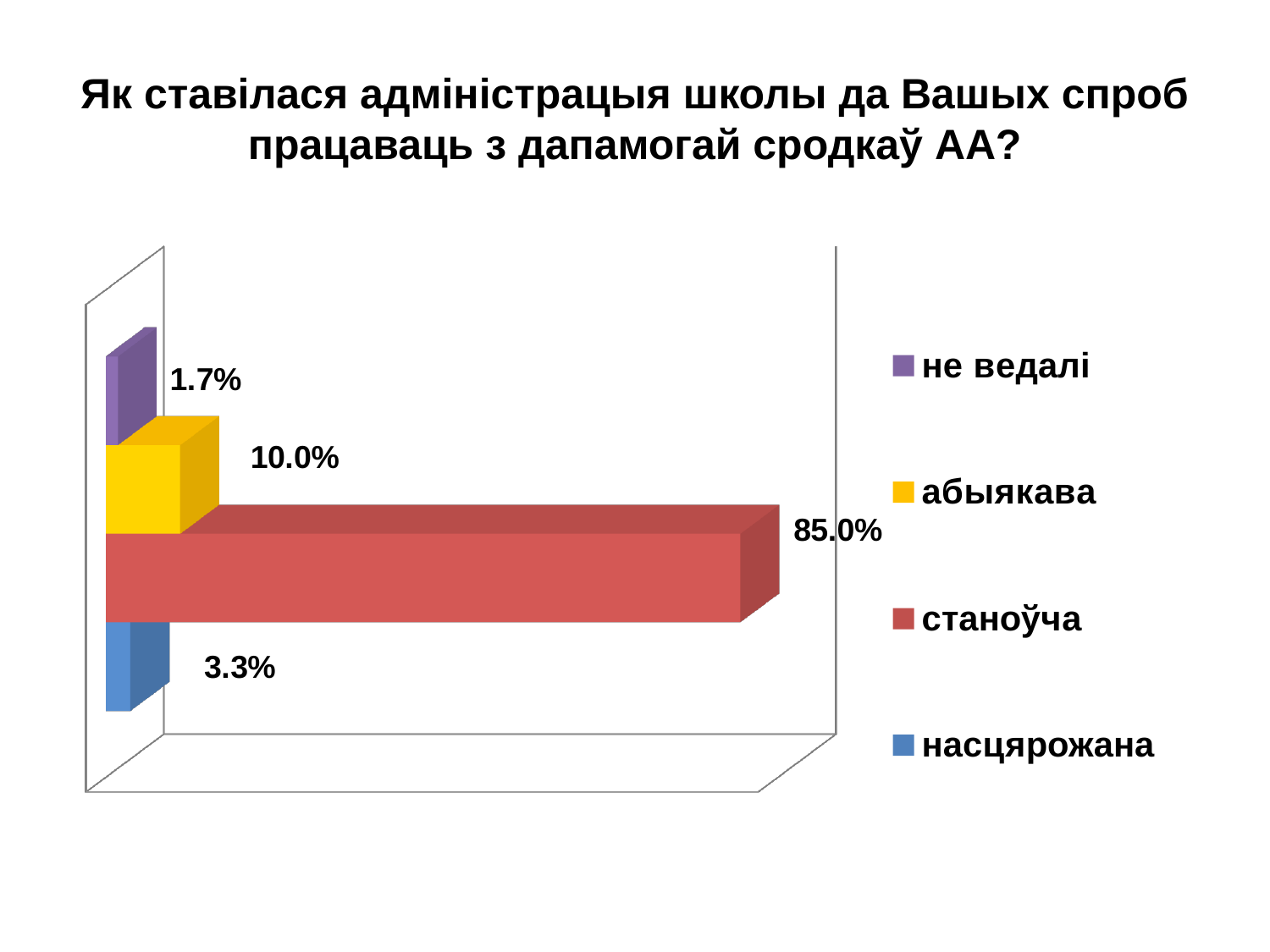
What is the value for станоўча? 85.0% What is the difference between the values for станоўча and абыякава? 75.0% What is the value for не ведалі? 1.7% Which is larger, the value for абыякава or the value for насцярожана? абыякава What is the value for абыякава? 10.0% Which category has the lowest value? не ведалі How many series does the legend list? 4 What is the value for насцярожана? 3.3% What is the difference between the values for насцярожана and не ведалі? 1.6% What colour is the bar for станоўча? red What kind of chart is shown on the slide? bar chart Which category has the highest value? станоўча